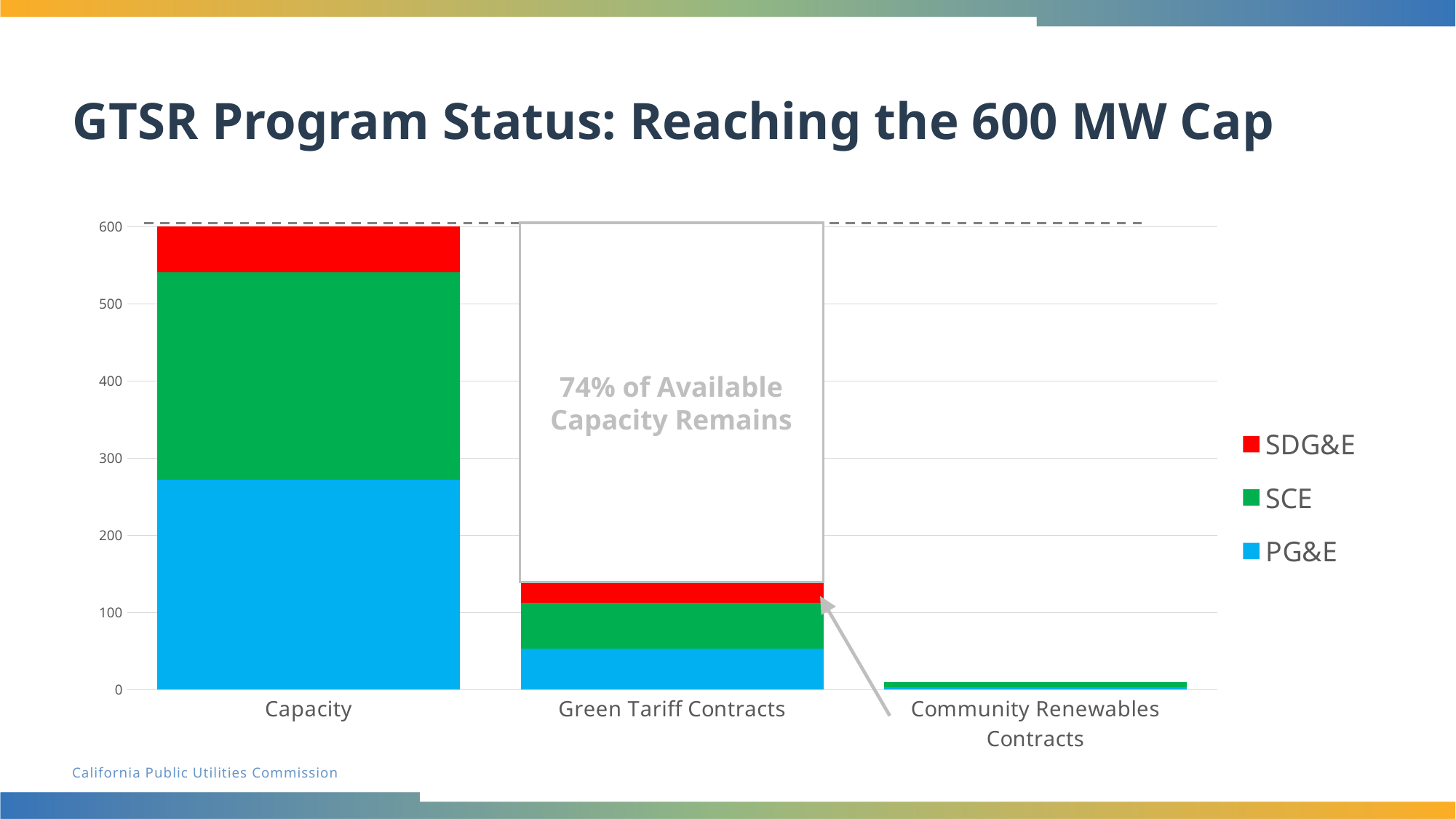
Which category has the shortest stacked bar? Community Renewables Contracts What is the total height of the Capacity bar, as marked by the dashed cap line? 600 Is the PG&E portion of the Capacity bar greater or less than 200? greater Is the total for Community Renewables Contracts greater or less than 100? less Is the total for Green Tariff Contracts greater or less than 200? less What does the text annotation inside the chart say? 74% of Available Capacity Remains How many categories are shown on the x axis of the chart? 3 How many series does the chart's legend list? 3 Which is larger, the total for Green Tariff Contracts or the total for Community Renewables Contracts? Green Tariff Contracts What kind of chart is shown on the slide? Stacked bar chart Which category has the tallest stacked bar? Capacity